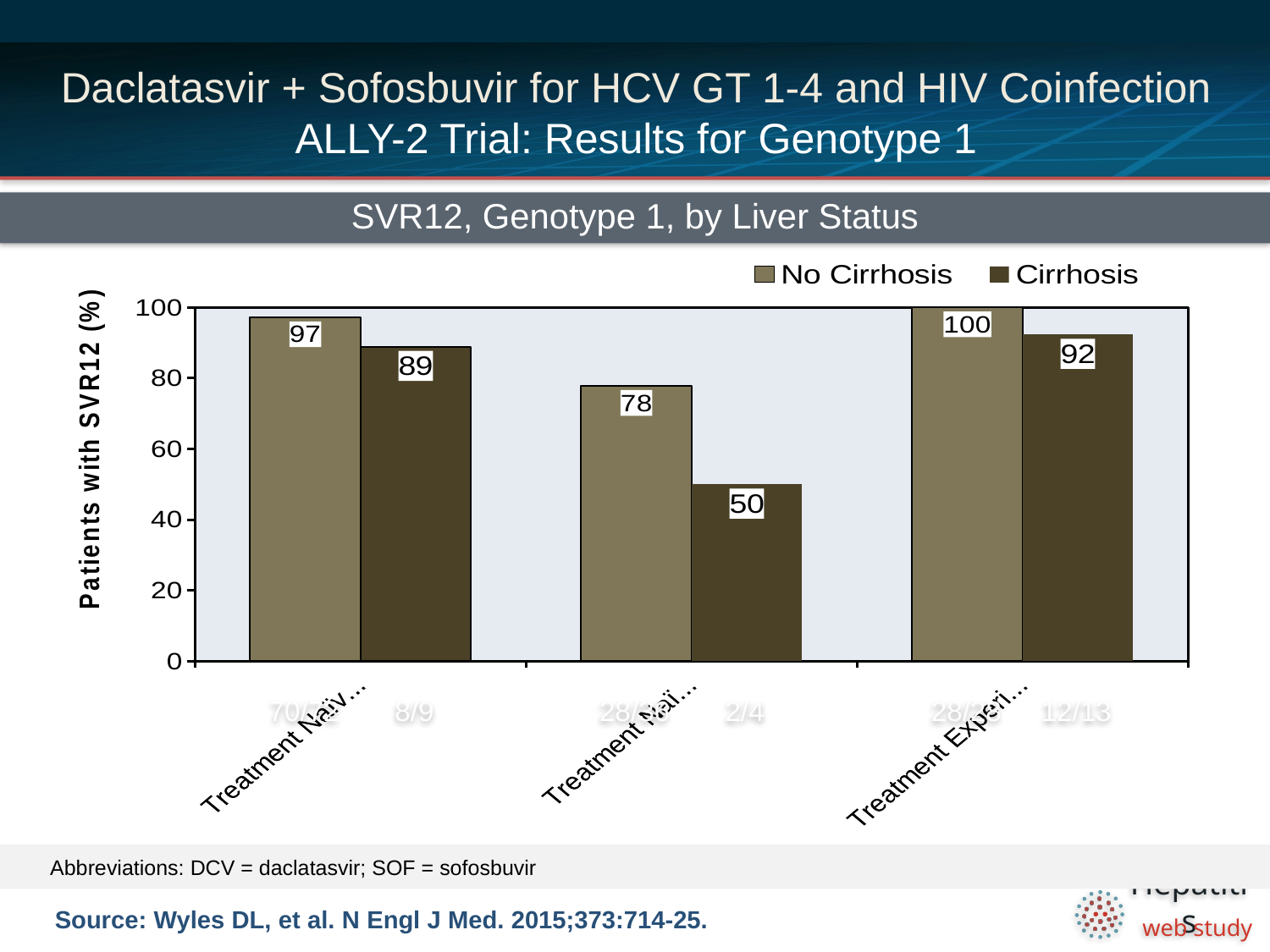
Which series has the lowest value in the chart, and what is it? Cirrhosis, 50 What is the No Cirrhosis value for the rightmost group of bars? 100 What is the Cirrhosis value for the leftmost group of bars? 89 How many series does the chart legend list? 2 What is the Cirrhosis value for the middle group of bars? 50 What is the label of the y axis? Patients with SVR12 (%) What is the No Cirrhosis value for the leftmost group of bars? 97 In the rightmost group of bars, which is larger: the No Cirrhosis value or the Cirrhosis value? No Cirrhosis What kind of chart is shown on the slide? bar chart How many groups of bars are plotted along the x axis? 3 What is the difference between the No Cirrhosis and Cirrhosis values in the middle group of bars? 28 What is the title of the chart? SVR12, Genotype 1, by Liver Status